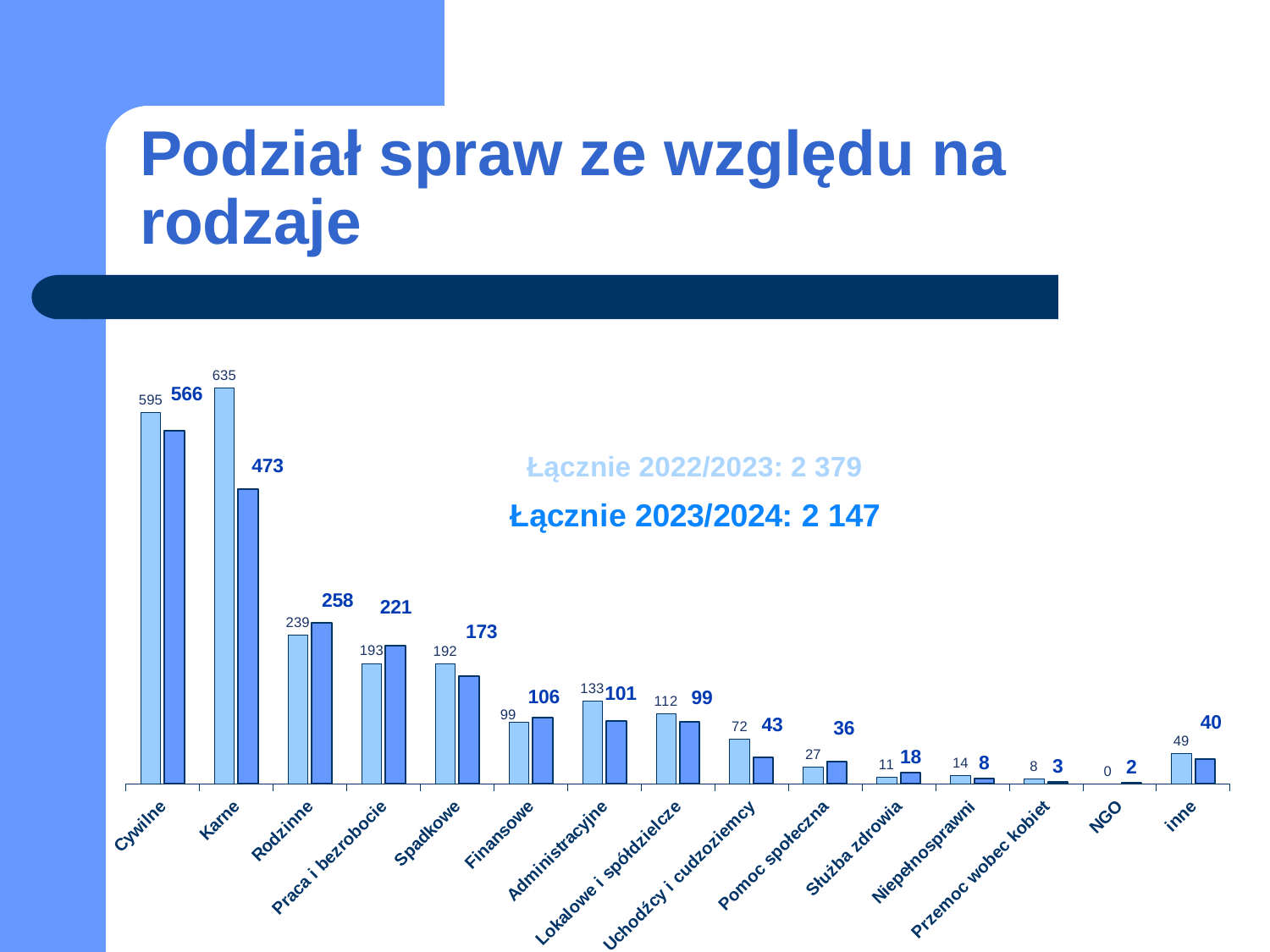
What is the value of the light blue bar for Uchodźcy i cudzoziemcy? 72 What kind of chart is shown on the slide? bar chart Which category has the highest light blue bar? Karne What is the difference between the light blue and dark blue bars for Administracyjne? 32 Which is larger for Pomoc społeczna, the light blue bar or the dark blue bar? the dark blue bar What is the title of the slide containing the chart? Podział spraw ze względu na rodzaje What is the value of the light blue bar for Karne? 635 What is the value of the dark blue bar for Rodzinne? 258 Which category has the lowest light blue bar? NGO What is the value of the dark blue bar for Cywilne? 566 How many categories are shown on the x axis of the chart? 15 What is the difference between the light blue and dark blue bars for Karne? 162